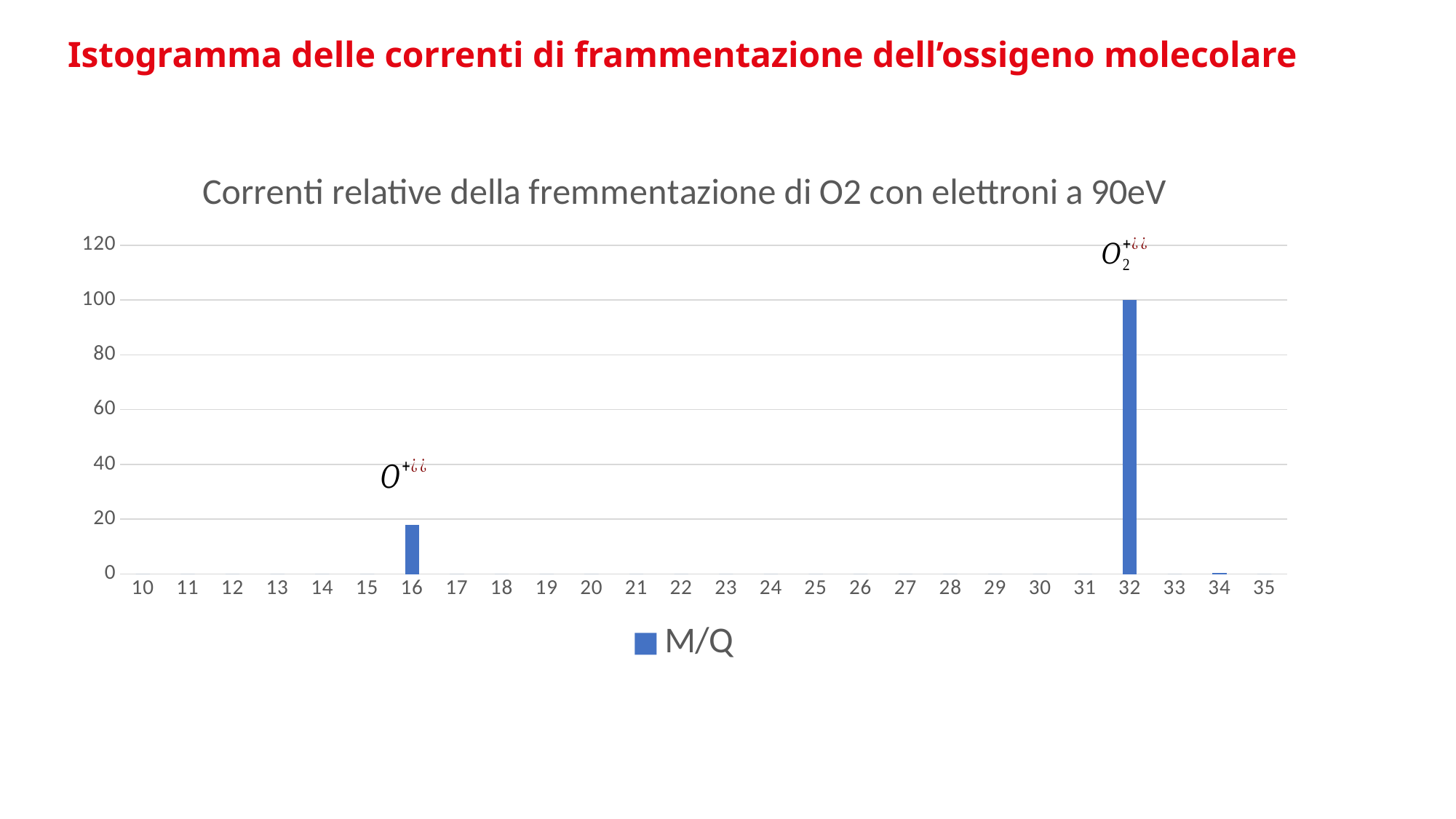
Which bar is taller, the one at x = 16 or the one at x = 34? 16 What is the title of the chart? Correnti relative della fremmentazione di O2 con elettroni a 90eV Is the value of the bar at x = 32 greater or less than 80? greater What is the first category label on the x axis? 10 How many series does the legend list? 1 How many categories are shown on the x axis? 26 Which bar is taller, the one at x = 16 or the one at x = 32? 32 What kind of chart is shown on the slide? bar chart What is the name of the series shown in the legend? M/Q What is the value of the bar at x = 32? 100 Is the value of the bar at x = 16 greater or less than 20? less Which x-axis category has the highest bar? 32